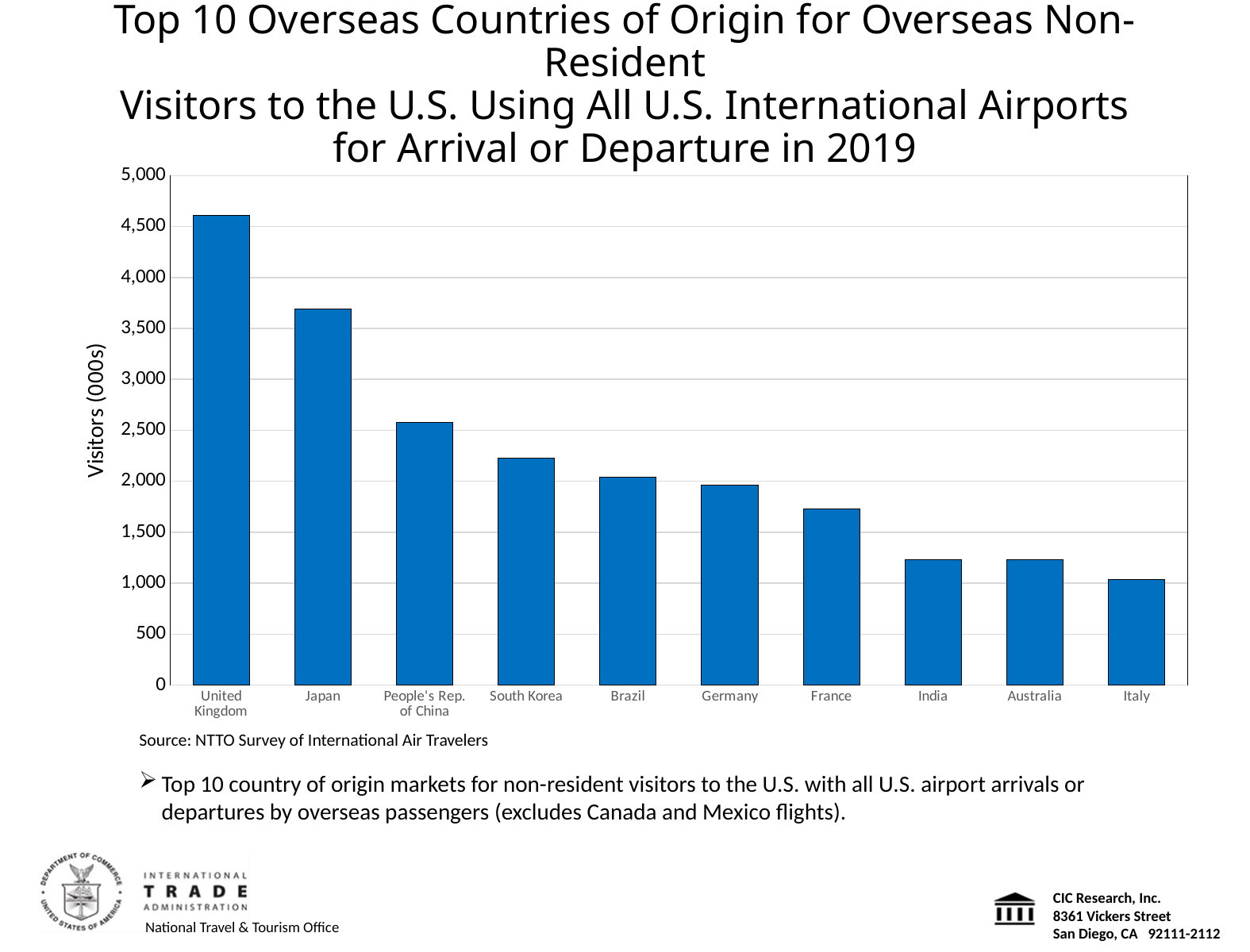
Is the value for India greater or less than 1,500? less Which has more visitors, Japan or People's Rep. of China? Japan What is the label on the vertical axis of the chart? Visitors (000s) Do the values rise or fall moving from left to right across the chart? fall Is the value for South Korea greater or less than 2,000? greater Is the value for Japan greater or less than 3,500? greater Which country has the highest number of visitors on the chart? United Kingdom What kind of chart is shown on the slide? bar chart How many countries are shown on the chart? 10 Which country has the lowest number of visitors on the chart? Italy